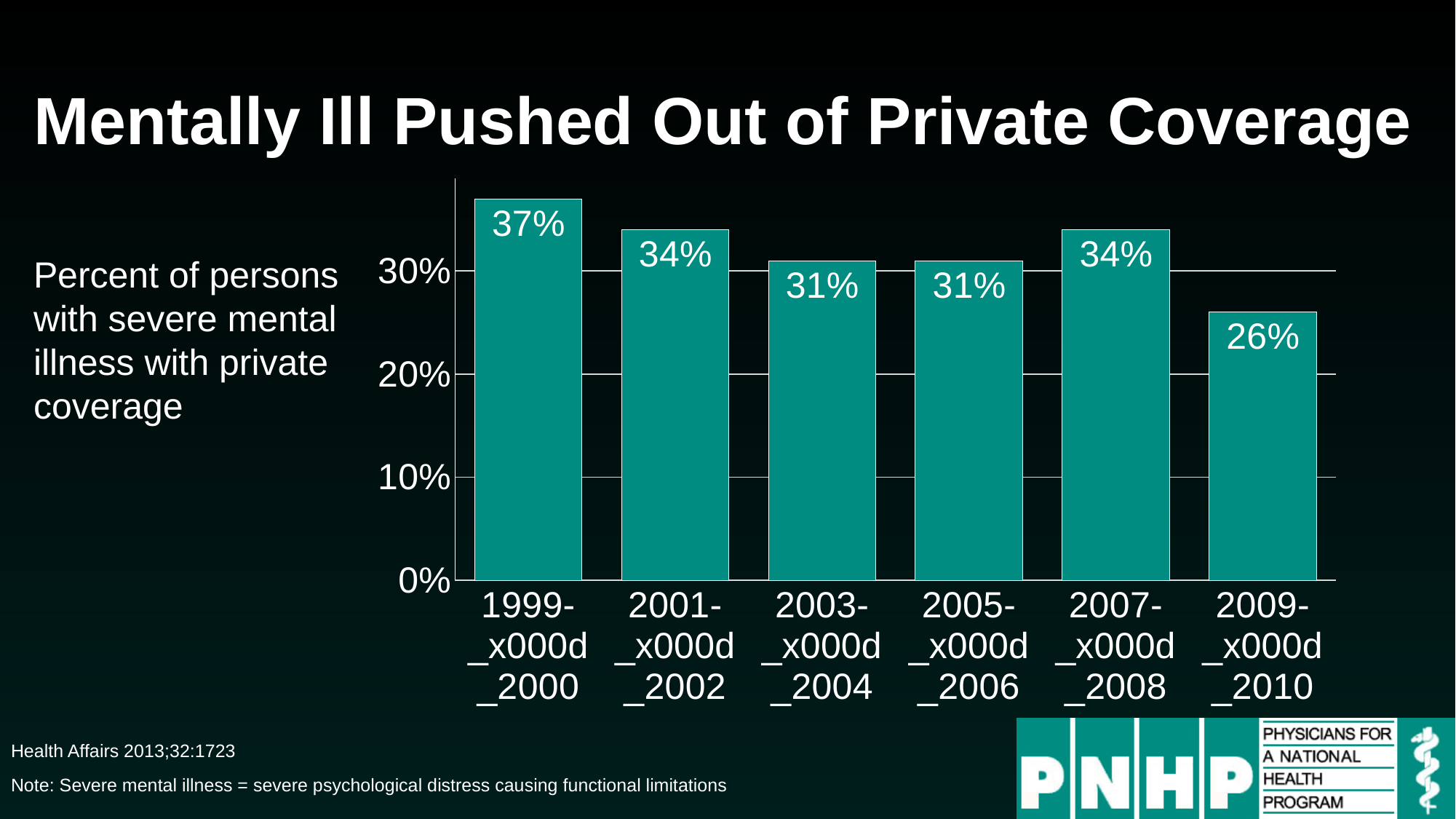
Is the value for 2009-2010 greater or less than 30%? less Do the values generally rise or fall from 1999-2000 to 2009-2010? fall Which is larger, the value for 2001-2002 or the value for 2005-2006? 2001-2002 What kind of chart is shown on the slide? bar chart What is the value for 2009-2010? 26% What is the value for 1999-2000? 37% Which period has the highest value? 1999-2000 What is the title of the slide? Mentally Ill Pushed Out of Private Coverage How many periods are shown on the chart? 6 What is the difference between the values for 1999-2000 and 2009-2010? 11% What is the value for 2003-2004? 31% Which period has the lowest value? 2009-2010